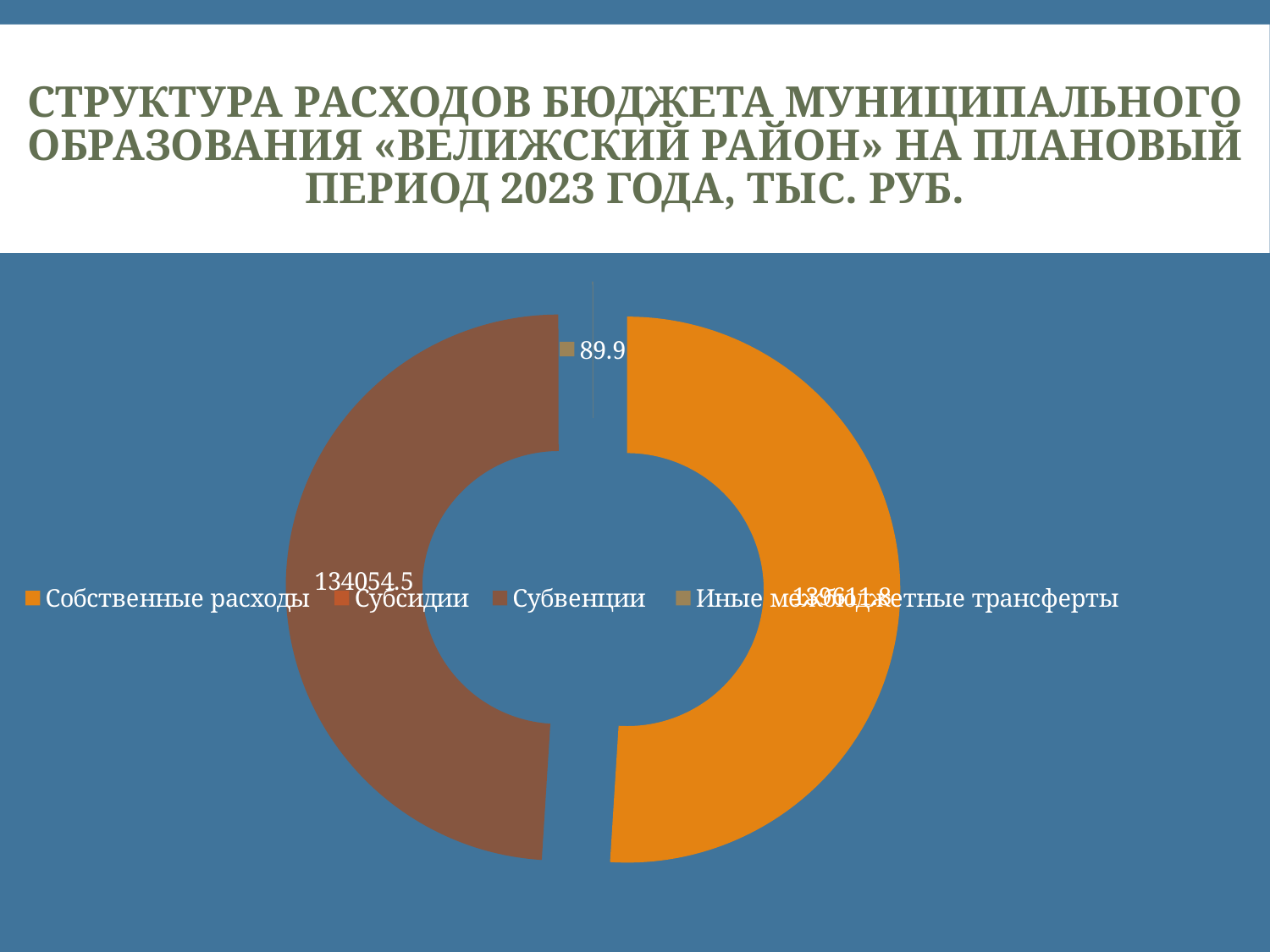
What is the value for Субвенции? 134054.5 Which is larger, Собственные расходы or Иные межбюджетные трансферты? Собственные расходы What colour represents Субвенции in the chart? brown Which is larger, Субвенции or Иные межбюджетные трансферты? Субвенции What kind of chart is shown on the slide? doughnut (pie) chart What is the difference between the values for Субвенции and Иные межбюджетные трансферты? 133964.6 How many categories does the legend list? 4 What is the title of the chart slide? Структура расходов бюджета муниципального образования «Велижский район» на плановый период 2023 года, тыс. руб. What is the value for Иные межбюджетные трансферты? 89.9